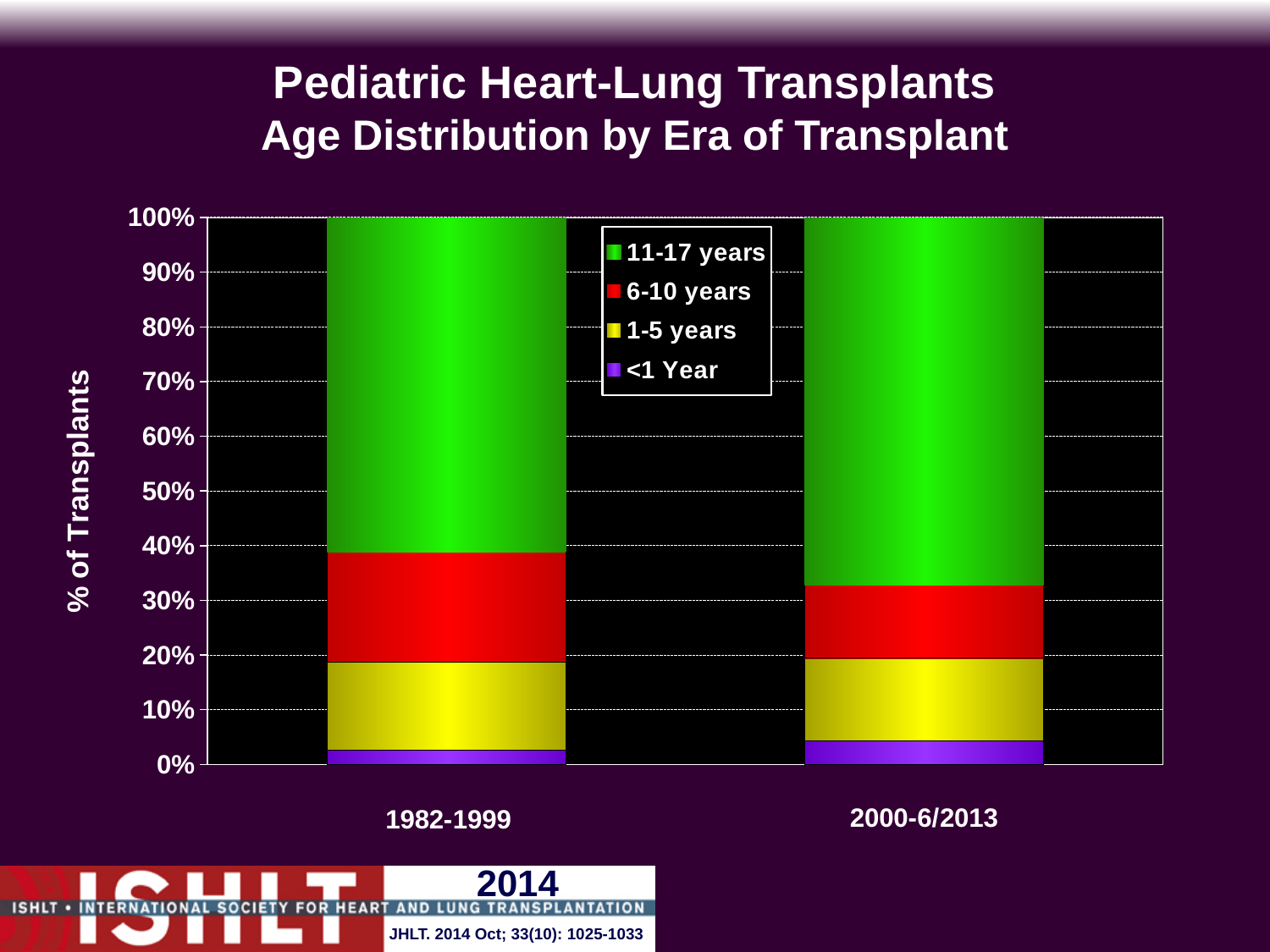
What is the total height of the stacked bar for 1982-1999? 100% What kind of chart is shown on the slide? stacked bar chart Which age group makes up the largest share of transplants in the 1982-1999 era? 11-17 years Is the share for 11-17 years in the 1982-1999 era greater or less than 50%? greater Which age group makes up the smallest share of transplants in the 2000-6/2013 era? <1 Year Which era has the larger share of 6-10 years transplants, 1982-1999 or 2000-6/2013? 1982-1999 How many series does the legend list? 4 Which era has the larger share of 11-17 years transplants, 1982-1999 or 2000-6/2013? 2000-6/2013 How many eras (categories) are shown on the x axis? 2 Is the share for <1 Year in the 1982-1999 era greater or less than 10%? less What colour represents the 6-10 years series in the legend? red Is the share for 11-17 years in the 2000-6/2013 era greater or less than 60%? greater